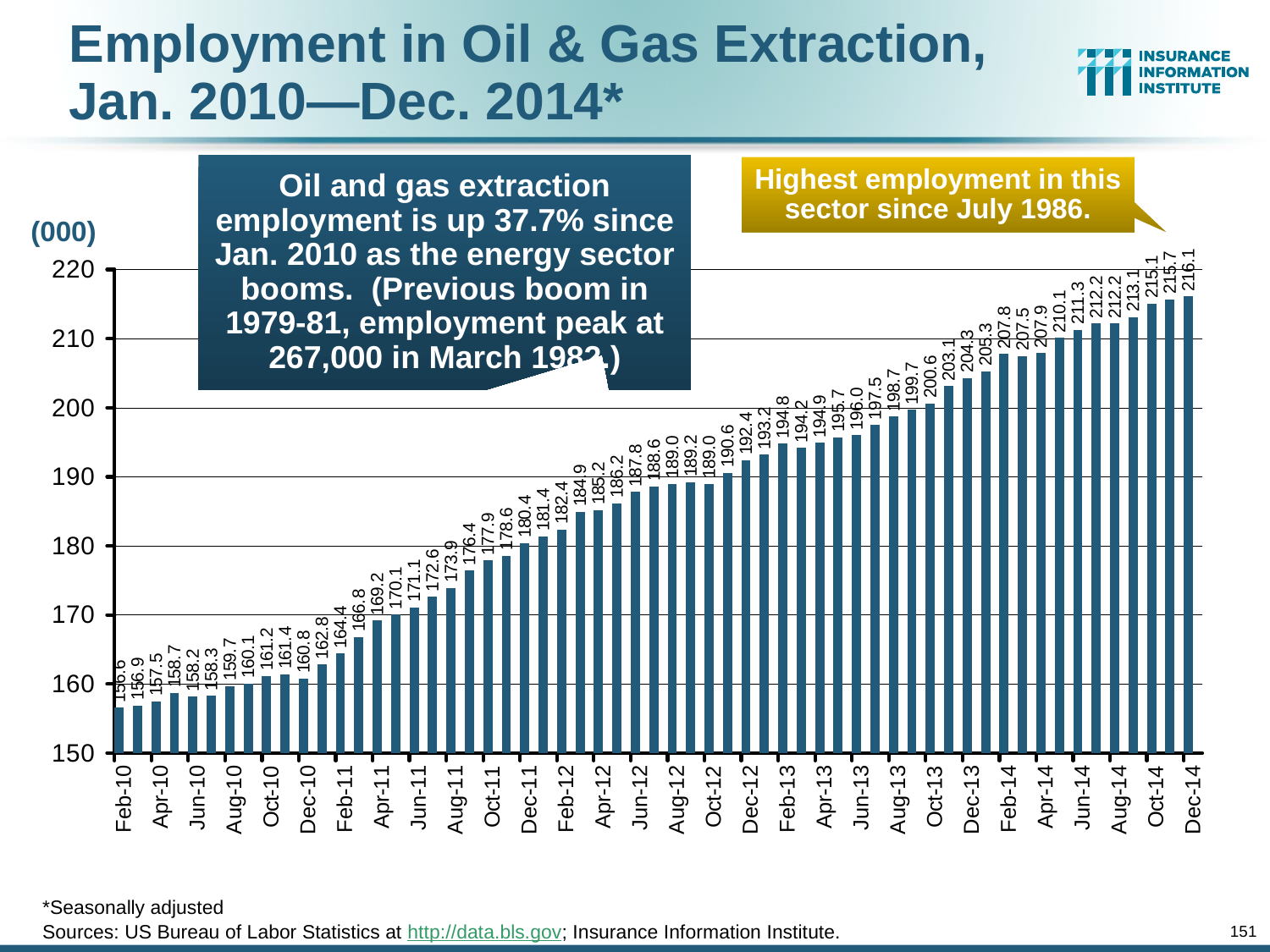
Which month has the highest employment value in the chart? Dec-14 Do the employment values generally rise or fall from Feb-10 to Dec-14? rise According to the yellow callout, since when is this the highest employment in the sector? July 1986 In what units are the employment values on the y axis expressed? (000) Which is larger, the value for Dec-14 or the value for Feb-10? Dec-14 Is the value for Dec-12 greater or less than 200? less Is the value for Feb-10 greater or less than 160? less What is the difference between the Dec-14 value and the Feb-10 value? 59.5 What kind of chart is shown on the slide? bar chart Is the value for Dec-14 greater or less than 210? greater What is the employment value (000) for Feb-10? 156.6 What is the employment value (000) for Dec-14? 216.1